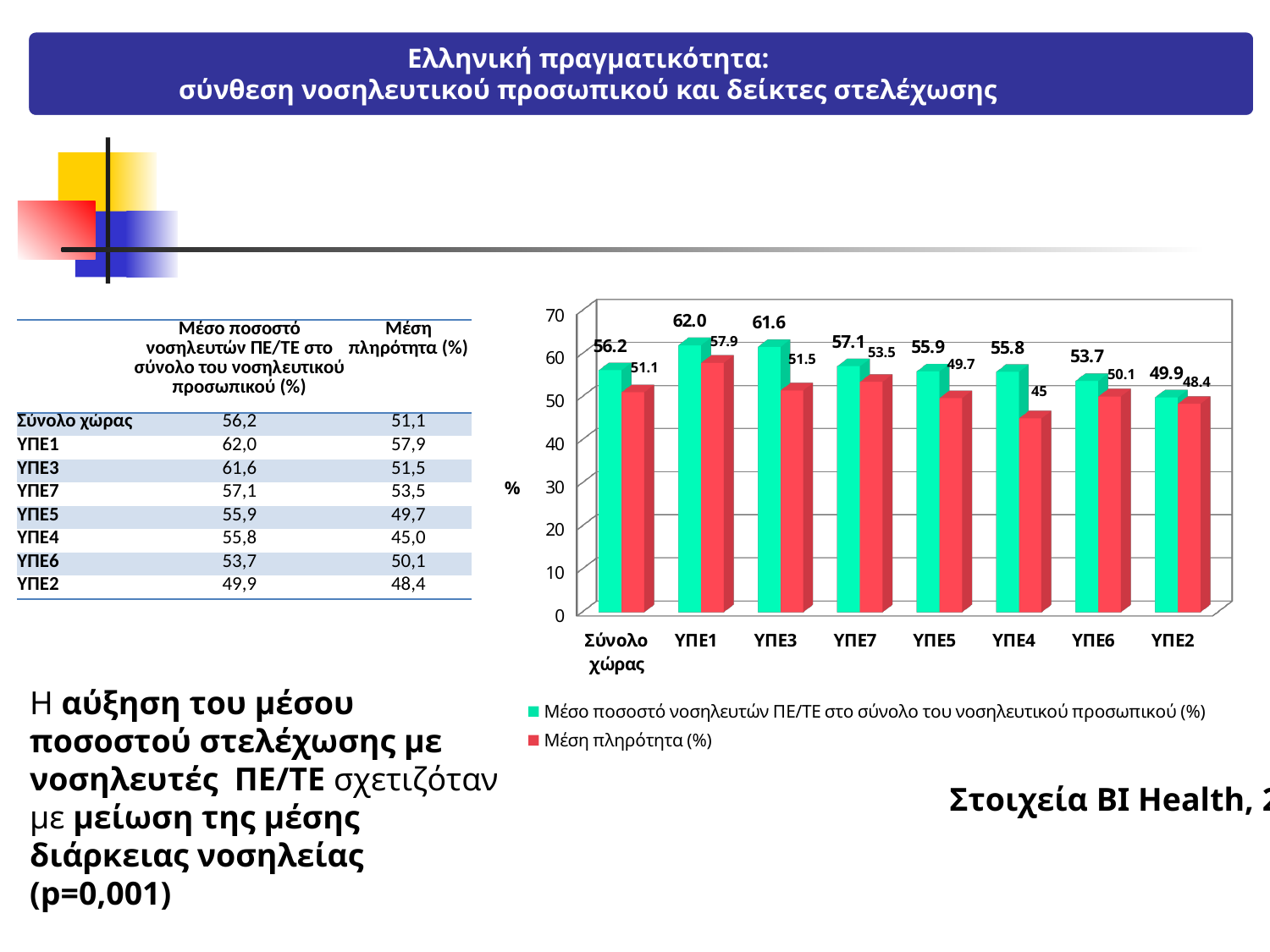
What is the value of Μέση πληρότητα (%) for ΥΠΕ4? 45 What kind of chart is shown on the slide? bar chart How many categories are shown on the x axis of the chart? 8 How many series does the chart legend list? 2 What is the value of Μέσο ποσοστό νοσηλευτών ΠΕ/ΤΕ στο σύνολο του νοσηλευτικού προσωπικού (%) for ΥΠΕ1? 62.0 Which category has the highest value for Μέσο ποσοστό νοσηλευτών ΠΕ/ΤΕ στο σύνολο του νοσηλευτικού προσωπικού (%)? ΥΠΕ1 What colour are the bars for Μέση πληρότητα (%)? red What is the value of Μέση πληρότητα (%) for Σύνολο χώρας? 51.1 For ΥΠΕ1, what is the difference between Μέσο ποσοστό νοσηλευτών ΠΕ/ΤΕ (%) and Μέση πληρότητα (%)? 4.1 Which category has the lowest value for Μέση πληρότητα (%)? ΥΠΕ4 Is the value of Μέση πληρότητα (%) for ΥΠΕ4 greater or less than 50? less Which has the larger value for Μέσο ποσοστό νοσηλευτών ΠΕ/ΤΕ (%), ΥΠΕ3 or ΥΠΕ7? ΥΠΕ3